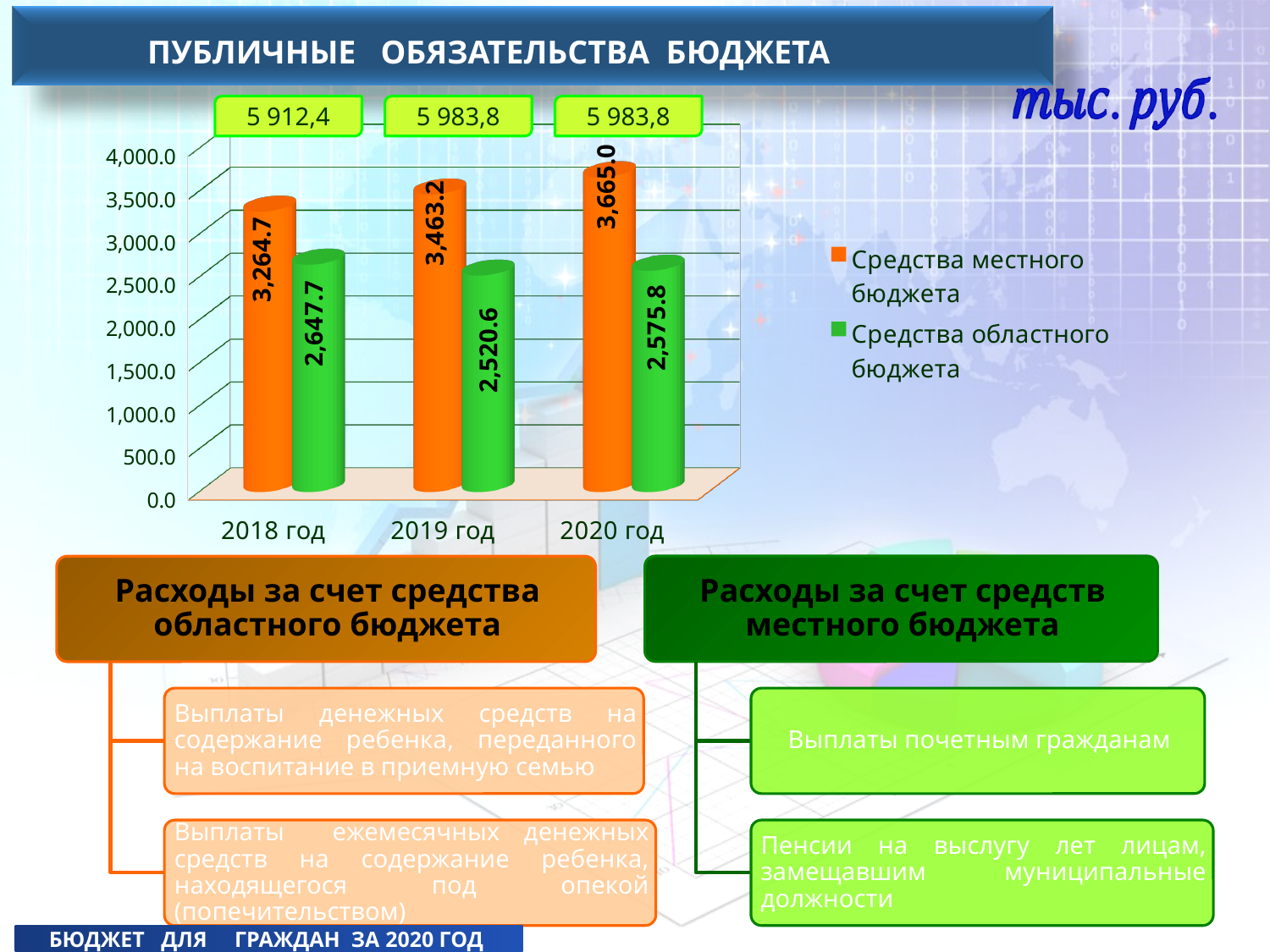
What is the difference between Средства местного бюджета and Средства областного бюджета in 2020 год? 1,089.2 How many series does the chart legend list? 2 What is the value for Средства местного бюджета in 2020 год? 3,665.0 What is the value for Средства областного бюджета in 2019 год? 2,520.6 In which year is the value for Средства местного бюджета highest? 2020 год In which year is the value for Средства областного бюджета lowest? 2019 год Is the value for Средства областного бюджета in 2018 год greater or less than 3,000.0? less Which is larger in 2018 год: Средства местного бюджета or Средства областного бюджета? Средства местного бюджета Does the value for Средства местного бюджета rise or fall from 2018 год to 2020 год? rise What is the value for Средства местного бюджета in 2018 год? 3,264.7 What kind of chart is shown on the slide? bar chart How many years are shown on the x axis of the chart? 3